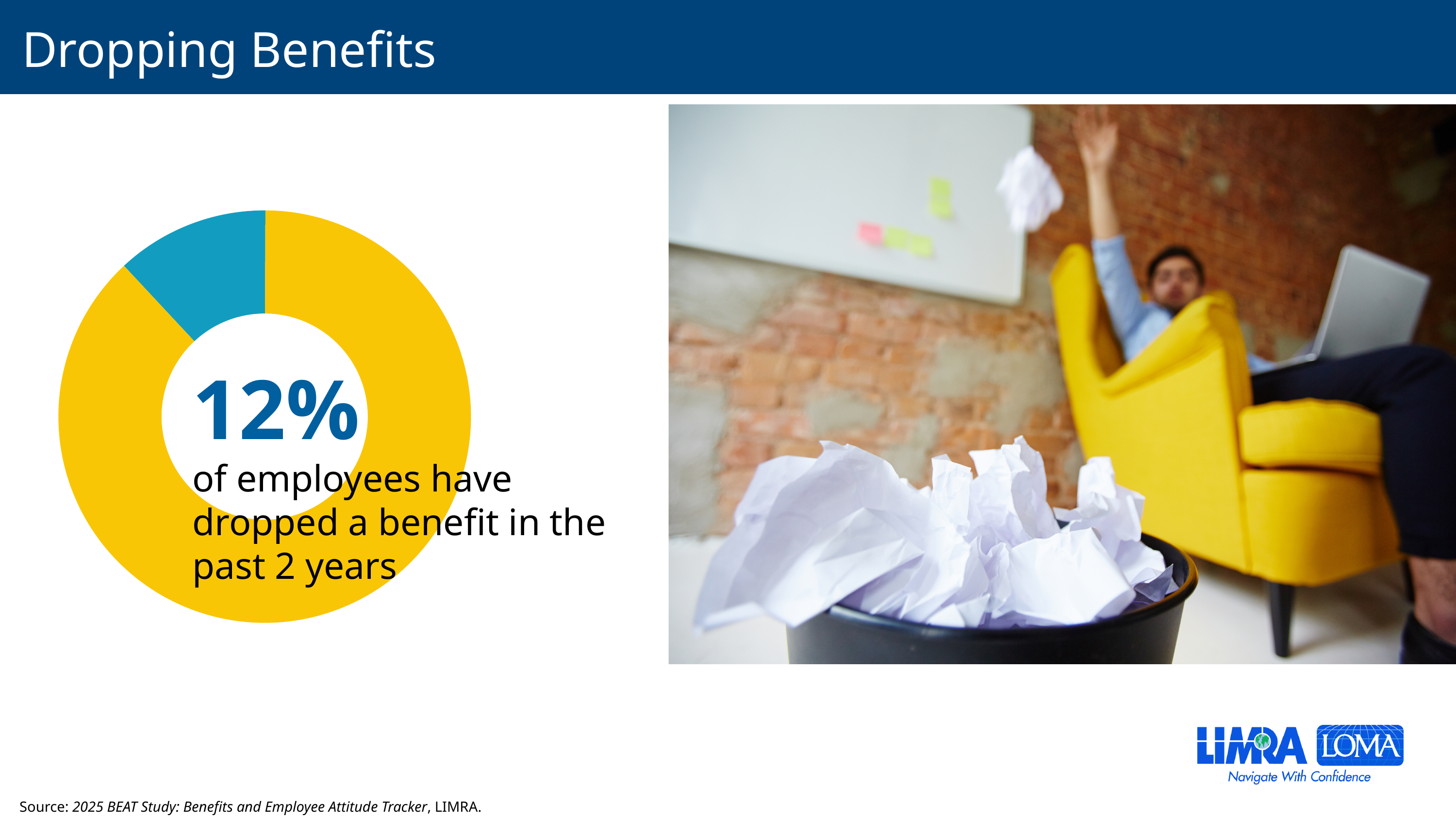
According to the chart, what percentage of employees have dropped a benefit in the past 2 years? 12% Which slice of the donut chart is larger, the blue one or the yellow one? the yellow one How many slices does the donut chart have? 2 What is the title of the slide containing the chart? Dropping Benefits What share of the donut chart does the yellow slice represent? 88% What colour is the slice representing the 12% of employees who dropped a benefit? blue What kind of chart is shown on the slide? donut (pie) chart